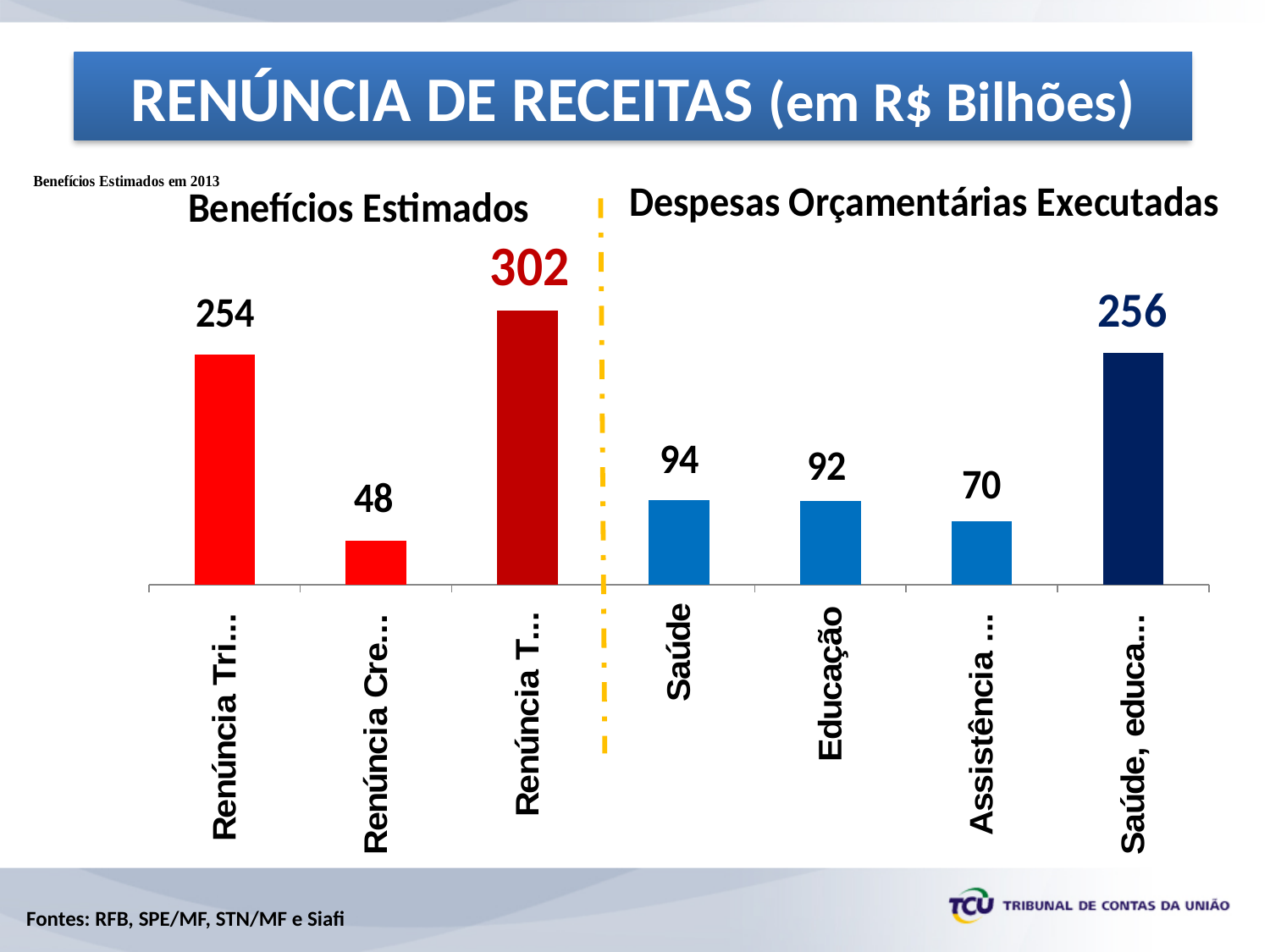
What is the lowest value shown in the chart? 48 What is the title of the slide? RENÚNCIA DE RECEITAS (em R$ Bilhões) How many bars are plotted in the chart? 7 What kind of chart is shown on the slide? Bar chart What is the value of the rightmost bar in the chart? 256 What is the value of the leftmost bar in the chart? 254 Which is larger, the value for Saúde or the value for Educação? Saúde What is the value for Educação? 92 What is the difference between the highest bar (302) and the rightmost bar (256)? 46 What is the difference between the values for Saúde and Educação? 2 What is the value for Saúde? 94 What is the highest value shown in the chart? 302